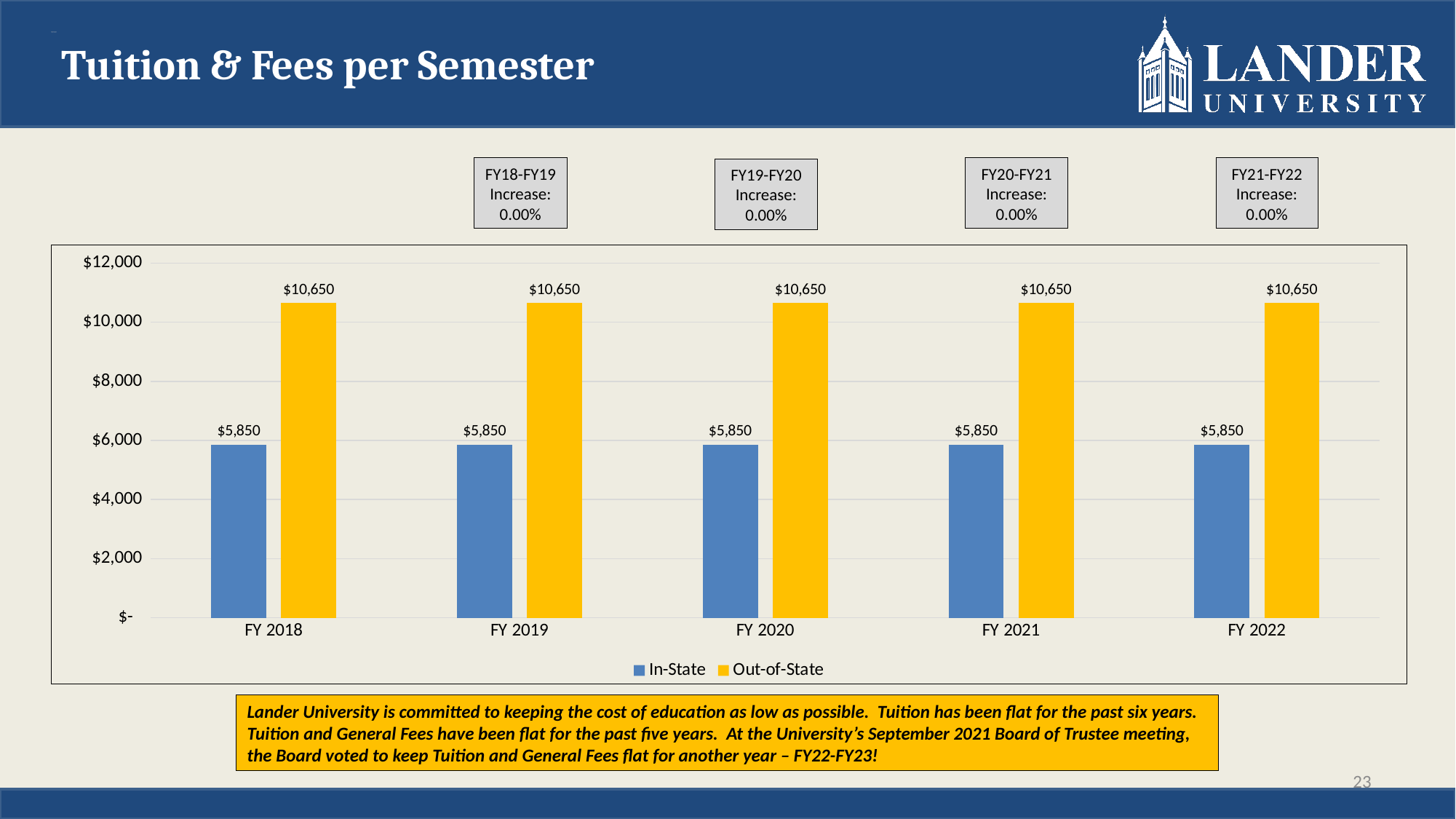
Do the In-State values rise, fall, or stay flat from FY 2018 to FY 2022? stay flat What is the Out-of-State tuition and fees value for FY 2022? $10,650 What kind of chart is shown on the slide? bar chart What is the In-State tuition and fees value for FY 2020? $5,850 Is the In-State value for FY 2019 greater or less than $6,000? less How many fiscal years are shown on the x axis? 5 Which is larger in FY 2021, the In-State value or the Out-of-State value? Out-of-State Which colour represents the Out-of-State series in the legend? yellow Is the Out-of-State value for FY 2020 greater or less than $10,000? greater What is the difference between the Out-of-State and In-State values for FY 2018? $4,800 How many series does the legend list? 2 What is the FY21-FY22 increase shown above the chart? 0.00%